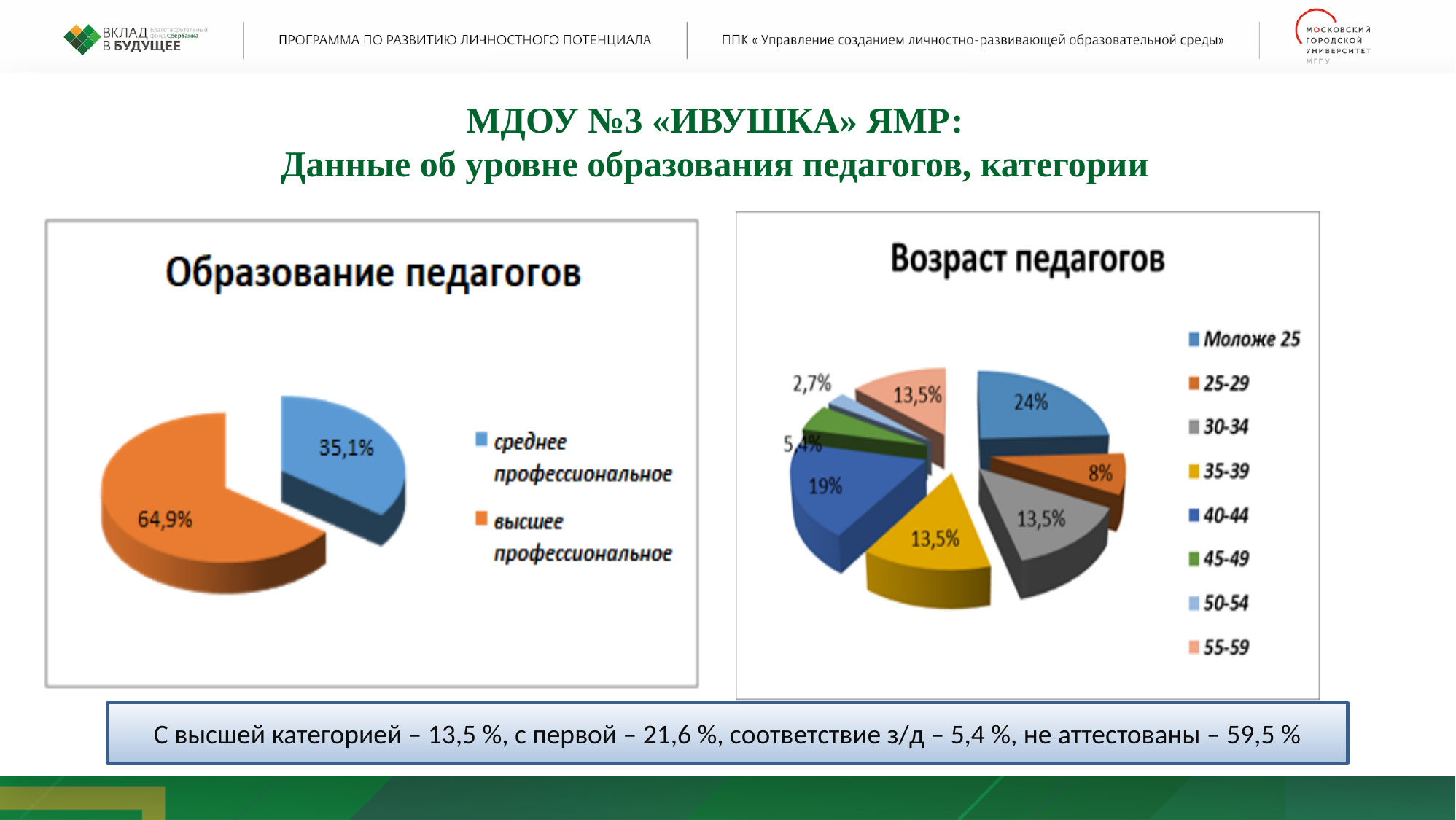
In the chart titled «Образование педагогов», what is the difference between the высшее профессиональное and среднее профессиональное shares? 29,8% How many age groups does the legend of the chart titled «Возраст педагогов» list? 8 In the chart titled «Возраст педагогов», which is larger: the share for 25-29 or the share for 45-49? 25-29 In the chart titled «Возраст педагогов», what is the difference between the shares for Моложе 25 and 25-29? 16% What kind of chart is the chart titled «Образование педагогов»? Pie chart In the chart titled «Возраст педагогов», which age group has the smallest share? 50-54 In the chart titled «Образование педагогов», what share of teachers have среднее профессиональное education? 35,1% In the chart titled «Возраст педагогов», what share of teachers are aged 40-44? 19% In the chart titled «Возраст педагогов», what share of teachers are aged 50-54? 2,7% In the chart titled «Возраст педагогов», which age group has the largest share? Моложе 25 In the chart titled «Образование педагогов», what share of teachers have высшее профессиональное education? 64,9% In the chart titled «Возраст педагогов», what share of teachers are Моложе 25? 24%